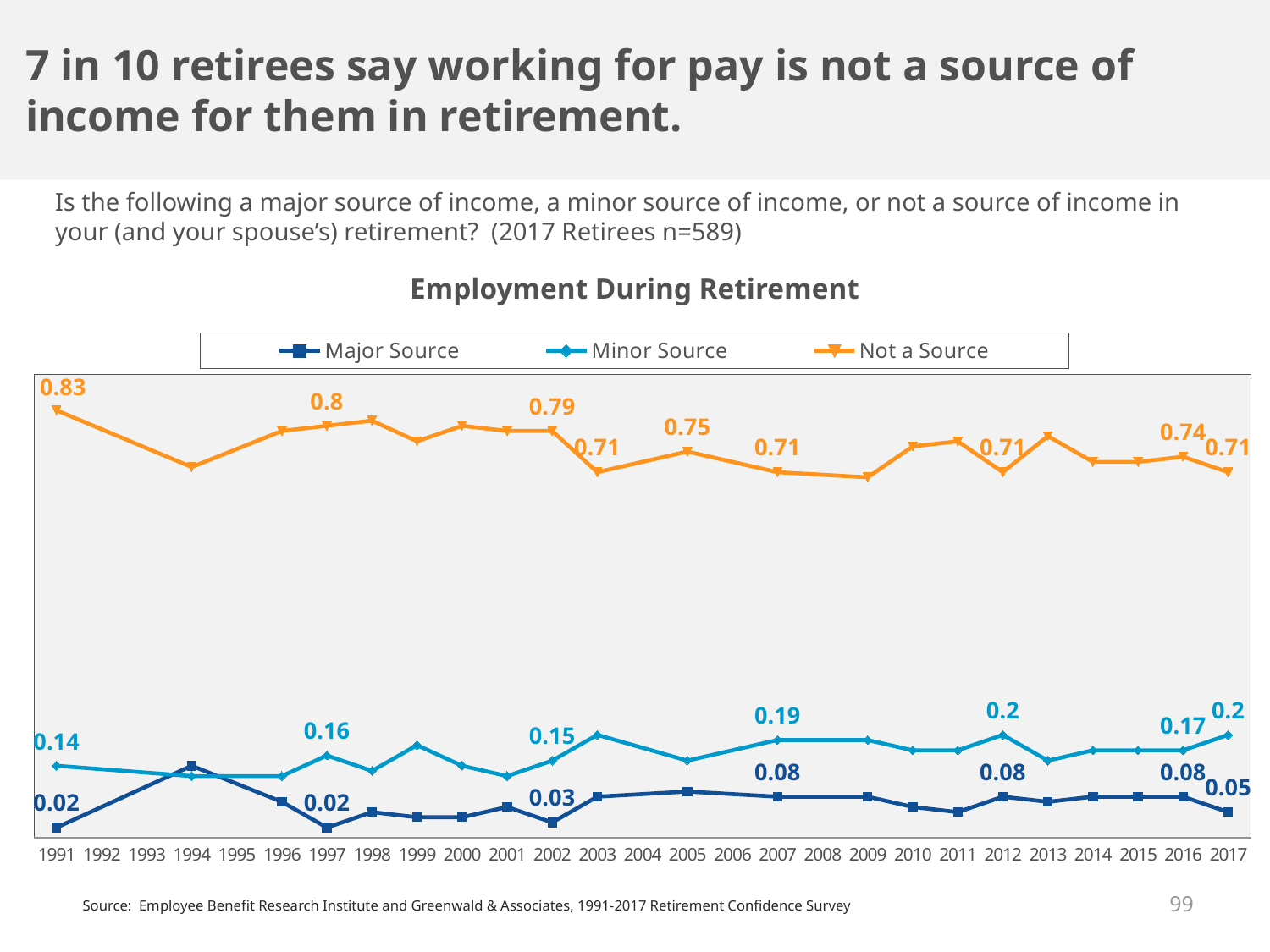
What is the difference between the Not a Source values in 1991 and 2017? 0.12 Which series has the lowest values across the chart? Major Source What is the value for Minor Source in 2017? 0.2 What is the value for Not a Source in 2005? 0.75 What is the value for Major Source in 2017? 0.05 What is the difference between the Major Source values in 2016 and 2017? 0.03 In which year does the Not a Source series reach its highest value? 1991 What is the value for Not a Source in 1991? 0.83 How many series does the legend list? 3 Does the Not a Source series rise or fall from 1991 to 2017? Fall Which is larger for Minor Source: the value in 2007 or the value in 2016? 2007 What kind of chart is shown? Line chart